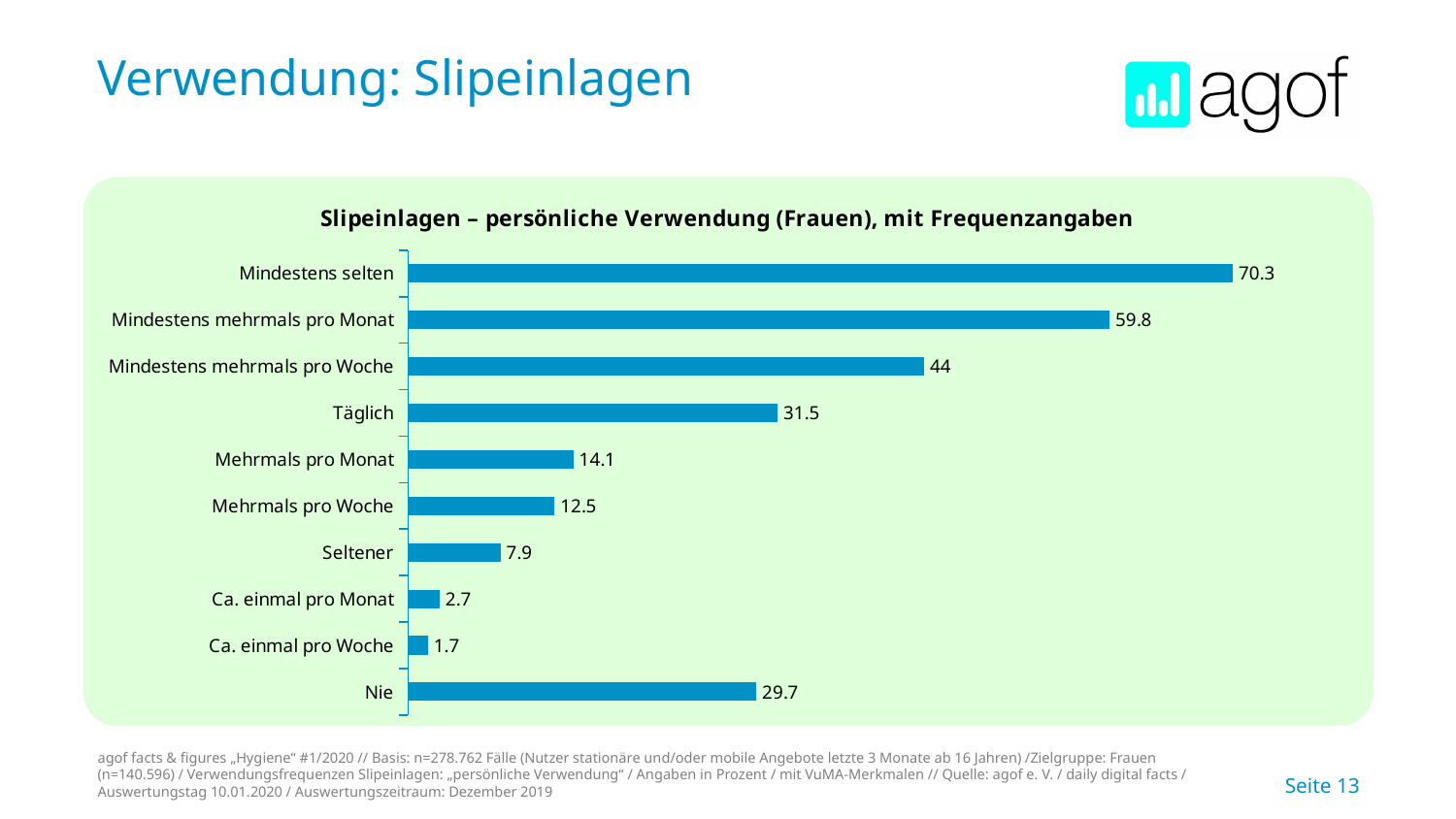
What is the title of the chart? Slipeinlagen – persönliche Verwendung (Frauen), mit Frequenzangaben What is the difference between "Mindestens selten" and "Mindestens mehrmals pro Monat"? 10.5 How many categories are shown in the chart? 10 What is the value for "Täglich"? 31.5 What kind of chart is shown on the slide? Bar chart What is the value for "Mindestens selten"? 70.3 Which category has the lowest value? Ca. einmal pro Woche Which category has the highest value? Mindestens selten Which is larger, the value for "Täglich" or the value for "Nie"? Täglich What is the value for "Ca. einmal pro Woche"? 1.7 What is the value for "Nie"? 29.7 What is the difference between "Mehrmals pro Monat" and "Mehrmals pro Woche"? 1.6